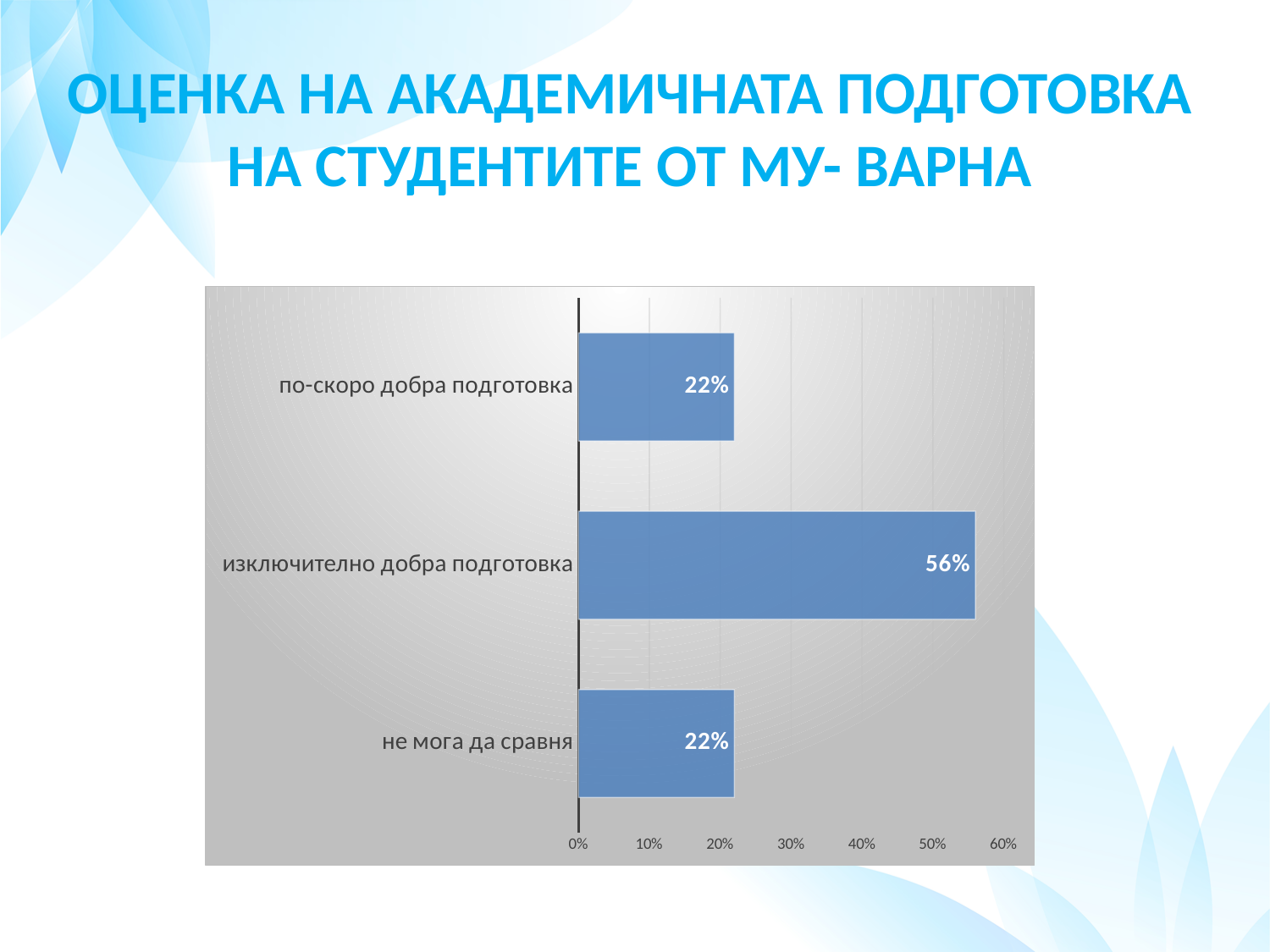
Which category has the highest value? изключително добра подготовка Which is larger: the value for "изключително добра подготовка" or the value for "не мога да сравня"? изключително добра подготовка What is the value for "по-скоро добра подготовка"? 22% How many categories are shown in the chart? 3 Is the value for "не мога да сравня" greater or less than 30%? less What is the title of the slide? ОЦЕНКА НА АКАДЕМИЧНАТА ПОДГОТОВКА НА СТУДЕНТИТЕ ОТ МУ- ВАРНА What is the highest value shown on the horizontal axis? 60% Is the value for "изключително добра подготовка" greater or less than 50%? greater What is the value for "изключително добра подготовка"? 56% What is the difference between the values for "изключително добра подготовка" and "по-скоро добра подготовка"? 34% What kind of chart is shown on the slide? bar chart What is the value for "не мога да сравня"? 22%